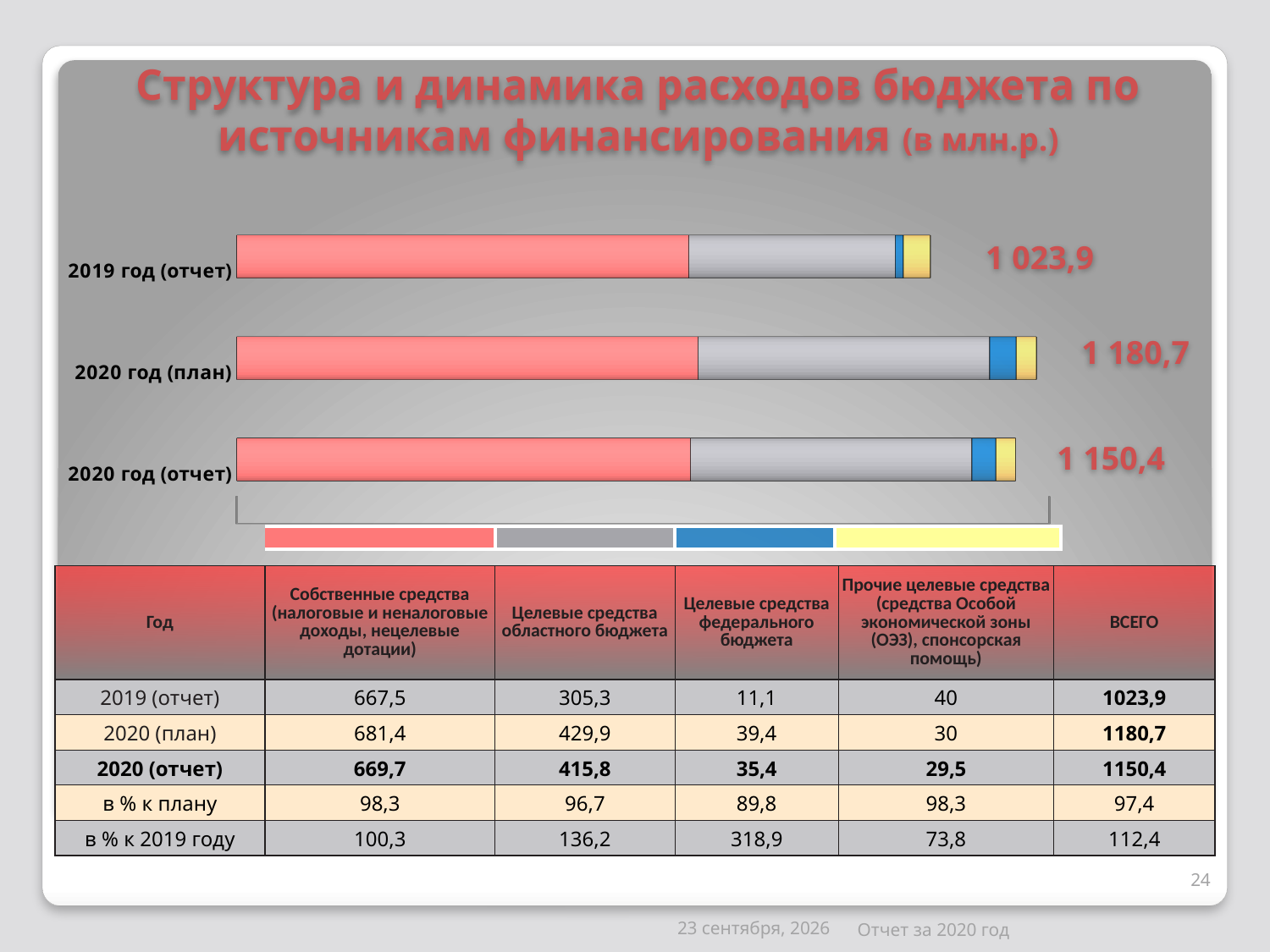
What is the difference between the totals for 2020 год (план) and 2020 год (отчет)? 30,3 How many bars (years) does the chart show? 3 How many series (colour swatches) does the chart legend show? 4 What is the total value printed next to the bar for 2020 год (отчет)? 1 150,4 Which is larger, the total for 2020 год (отчет) or for 2019 год (отчет)? 2020 год (отчет) What is the difference between the totals for 2020 год (план) and 2019 год (отчет)? 156,8 What kind of chart is shown on the slide? Stacked bar chart Which bar has the highest total? 2020 год (план) Which bar has the lowest total? 2019 год (отчет) What is the total value printed next to the bar for 2020 год (план)? 1 180,7 What is the total value printed next to the bar for 2019 год (отчет)? 1 023,9 According to the table, what is the value of Собственные средства for 2020 (отчет)? 669,7